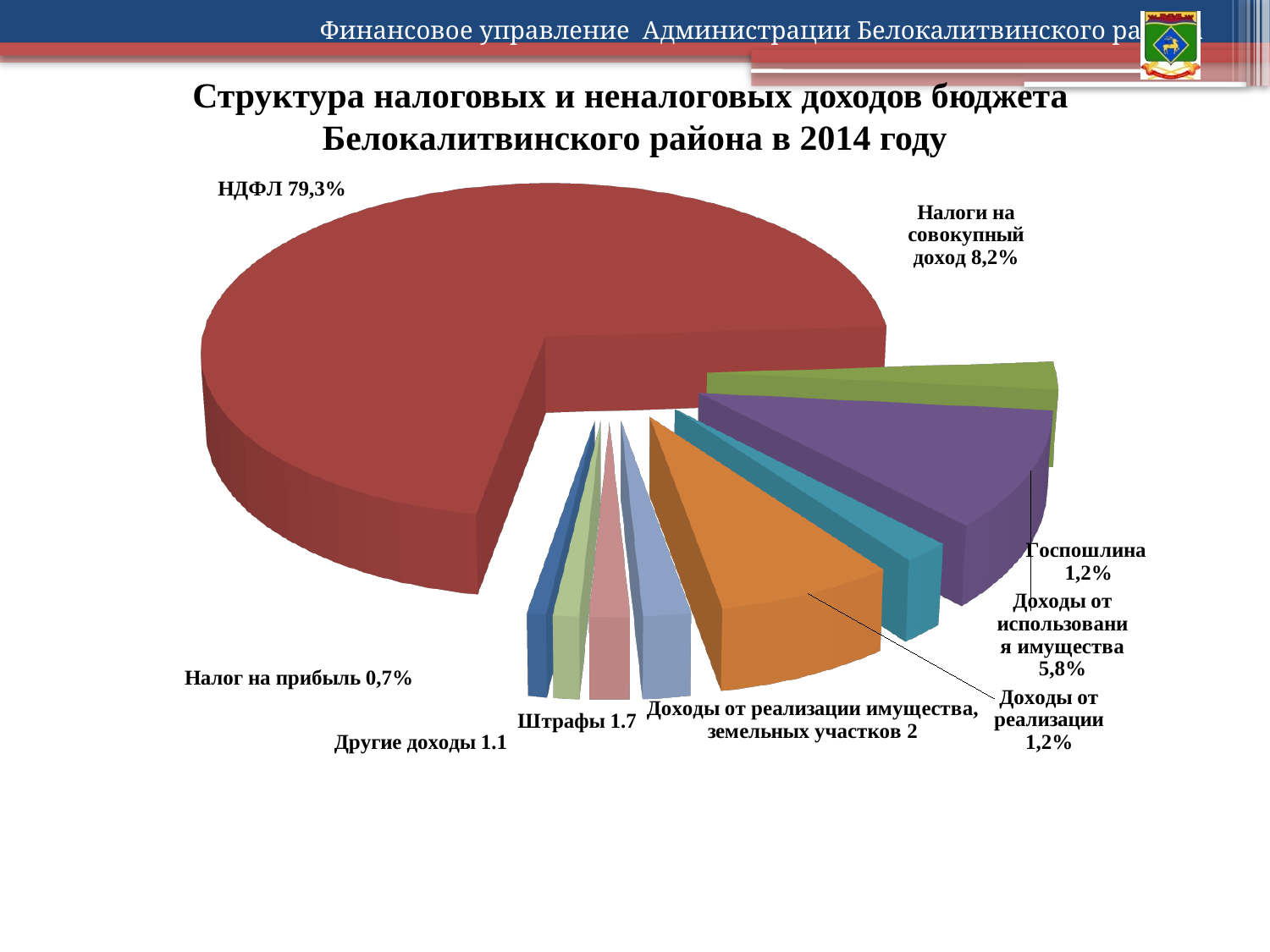
What is the difference in percentage points between НДФЛ and Налоги на совокупный доход? 71,1 What share of the pie does НДФЛ account for? 79,3% What value is shown for Налоги на совокупный доход? 8,2% What value is shown for Штрафы? 1.7 Which category has the largest share of the pie? НДФЛ What value is shown for Госпошлина? 1,2% Which is larger: Штрафы or Другие доходы? Штрафы How many slices does the pie chart have? 9 Which category has the smallest share of the pie? Налог на прибыль What value is shown for Доходы от использования имущества? 5,8% What year does the chart title refer to? 2014 What type of chart is shown on the slide? Pie chart